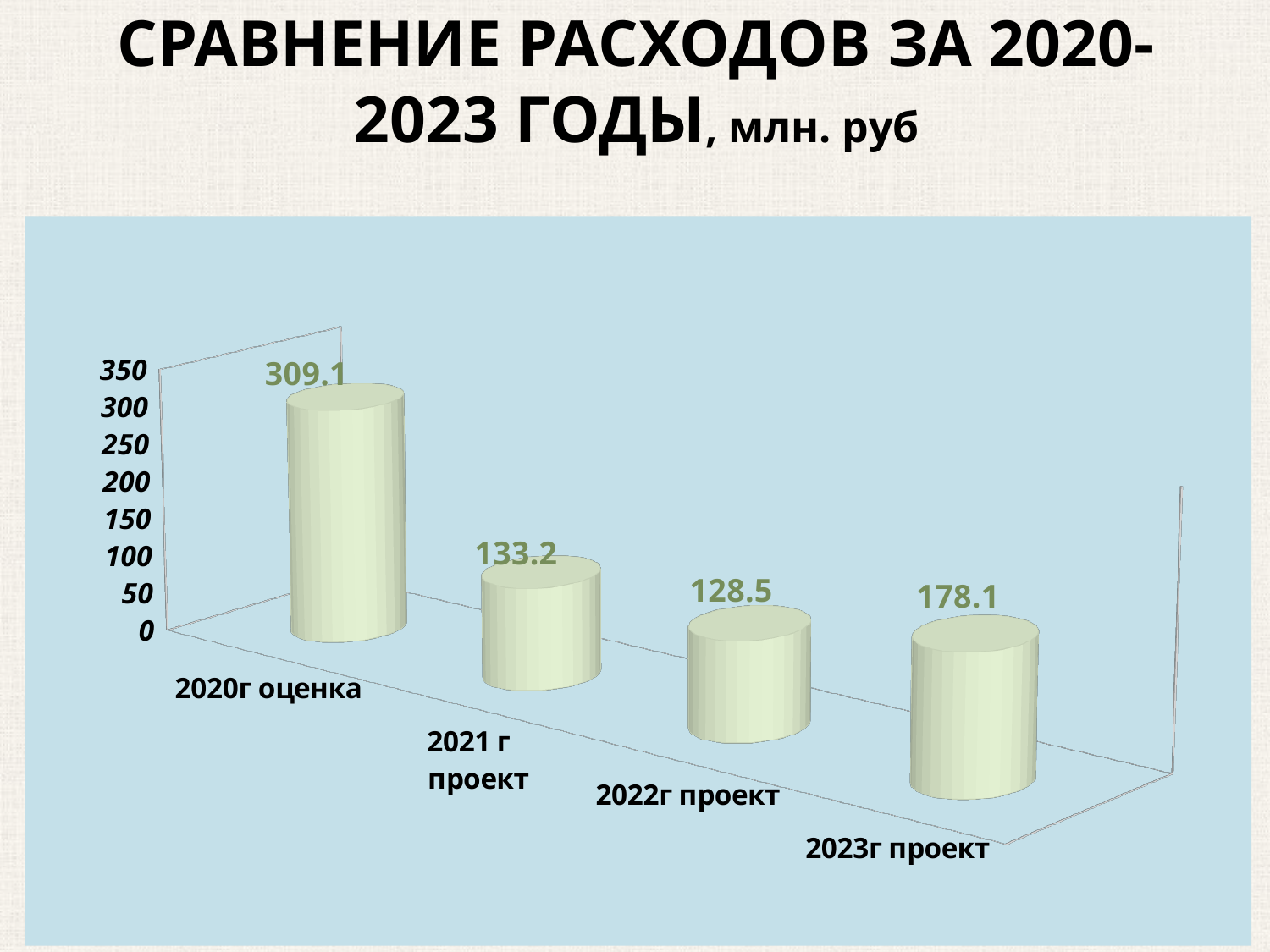
What is the value for 2022г проект? 128.5 What is the value for 2020г оценка? 309.1 What is the difference between the values for 2020г оценка and 2023г проект? 131.0 Which is larger, the value for 2023г проект or the value for 2021 г проект? 2023г проект What unit is given in the chart title? млн. руб How many categories are shown in the chart? 4 What is the value for 2021 г проект? 133.2 Which category has the lowest value? 2022г проект What is the value for 2023г проект? 178.1 What kind of chart is shown on the slide? bar chart What is the difference between the values for 2021 г проект and 2022г проект? 4.7 Which category has the highest value? 2020г оценка